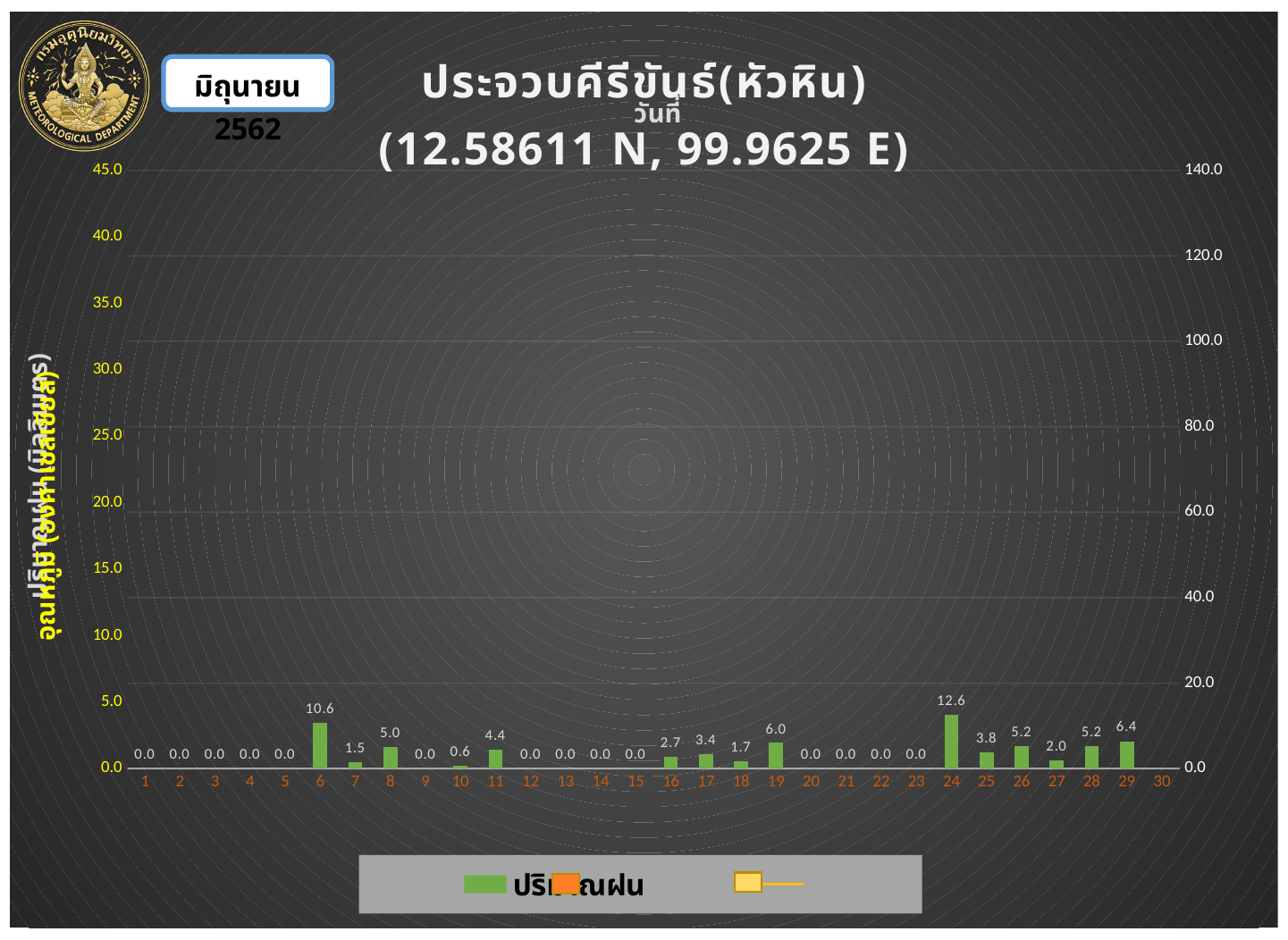
What is the difference between the values for day 8 and day 7? 3.5 What is the difference between the values for day 24 and day 6? 2.0 Which day has the highest rainfall value? 24 How many days are shown along the x axis? 30 What is the value labelled on the bar for day 19? 6.0 What is the value labelled on the bar for day 11? 4.4 What is the highest tick value shown on the right-hand axis? 140.0 What is the rainfall value shown for day 6? 10.6 Which is larger, the value for day 29 or the value for day 19? day 29 What kind of chart is used to show the rainfall values? bar chart What is the rainfall value shown for day 24? 12.6